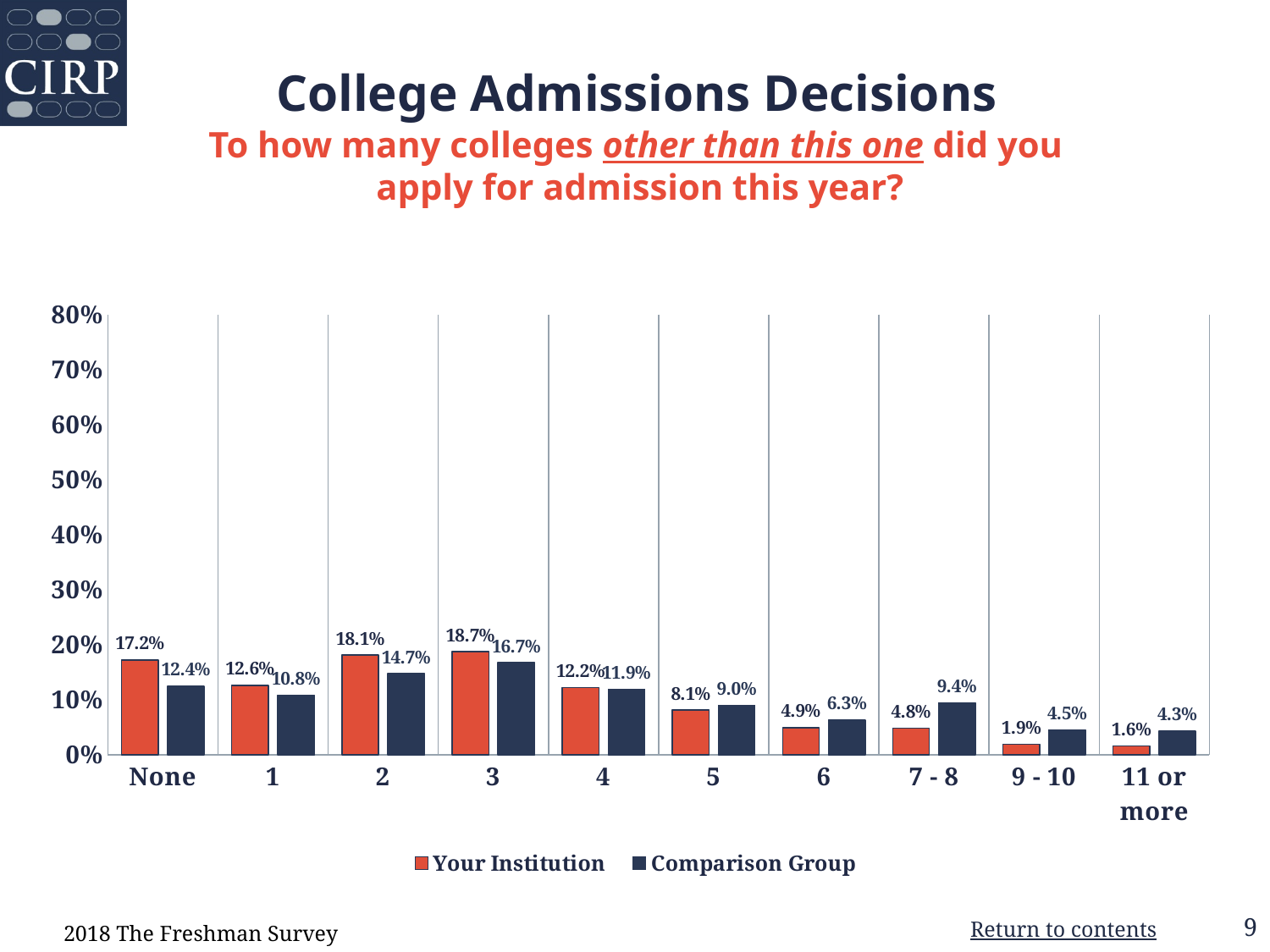
What colour are the Your Institution bars? Orange-red How many series does the legend list? 2 What is the difference between Your Institution and Comparison Group in the None category? 4.8% What kind of chart is shown on the slide? Bar chart Which is larger in the 6 category, Your Institution or Comparison Group? Comparison Group What is the value for Comparison Group in the 7 - 8 category? 9.4% How many categories are shown on the x axis? 10 Do the Comparison Group values rise or fall from category 3 to category 11 or more? Fall What is the value for Your Institution in the None category? 17.2% Is the value for Your Institution in the 2 category greater or less than 20%? less Which category has the highest value for Your Institution? 3 Which category has the lowest value for Comparison Group? 11 or more